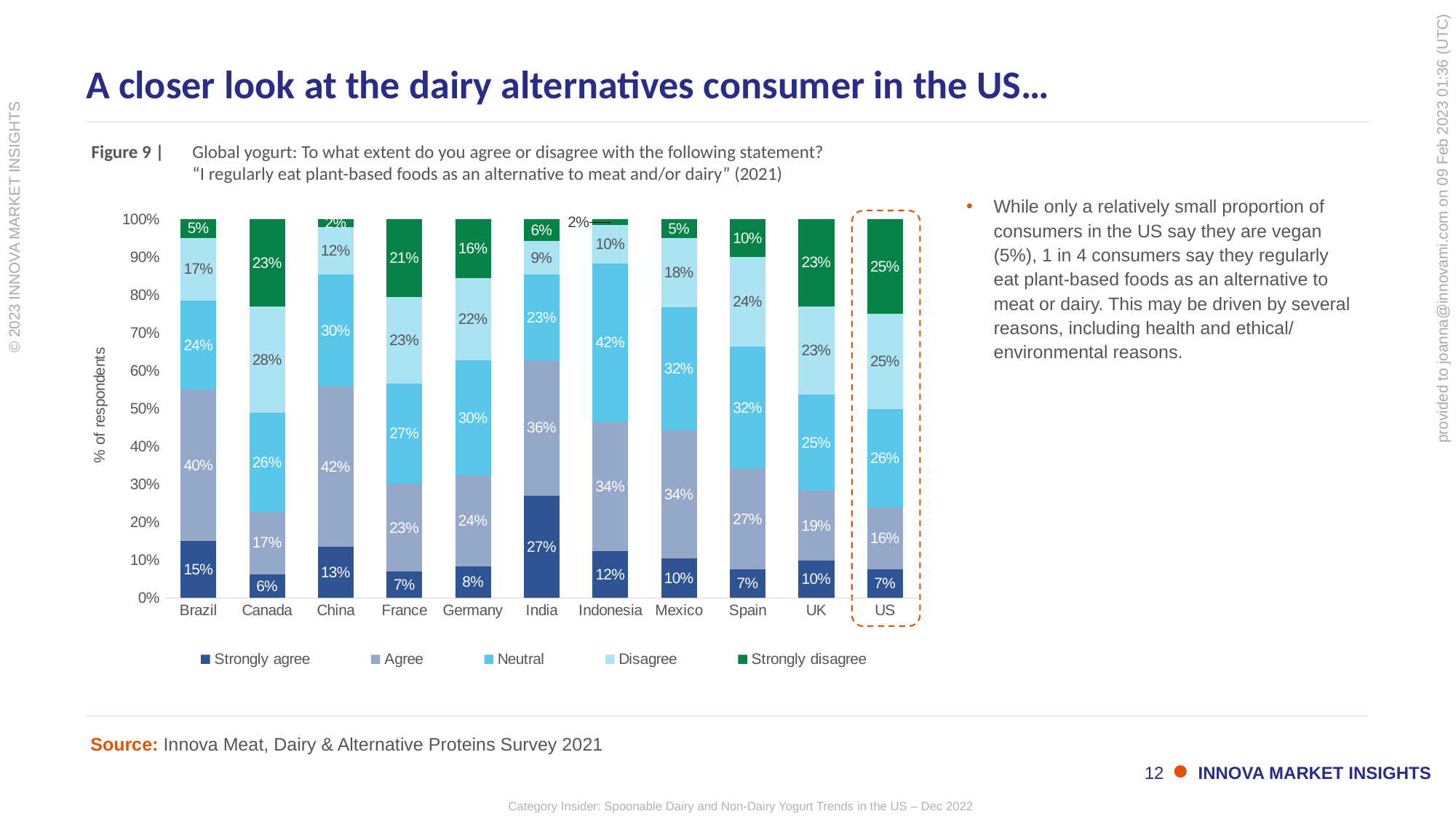
What kind of chart is shown on the slide? Stacked bar chart Which country has the highest Strongly agree value? India What percentage of respondents in India strongly agree with the statement? 27% Which has a larger Neutral value, Indonesia or Mexico? Indonesia What is the difference between the Strongly disagree values for the US and Brazil? 20 percentage points How many countries are shown on the x axis? 11 What percentage of respondents in the US strongly disagree with the statement? 25% Which country is highlighted with a dashed orange outline? US How many series does the legend list? 5 What is the Neutral value for Indonesia? 42% Which country has the lowest Strongly agree value? Canada What is the Agree value for China? 42%